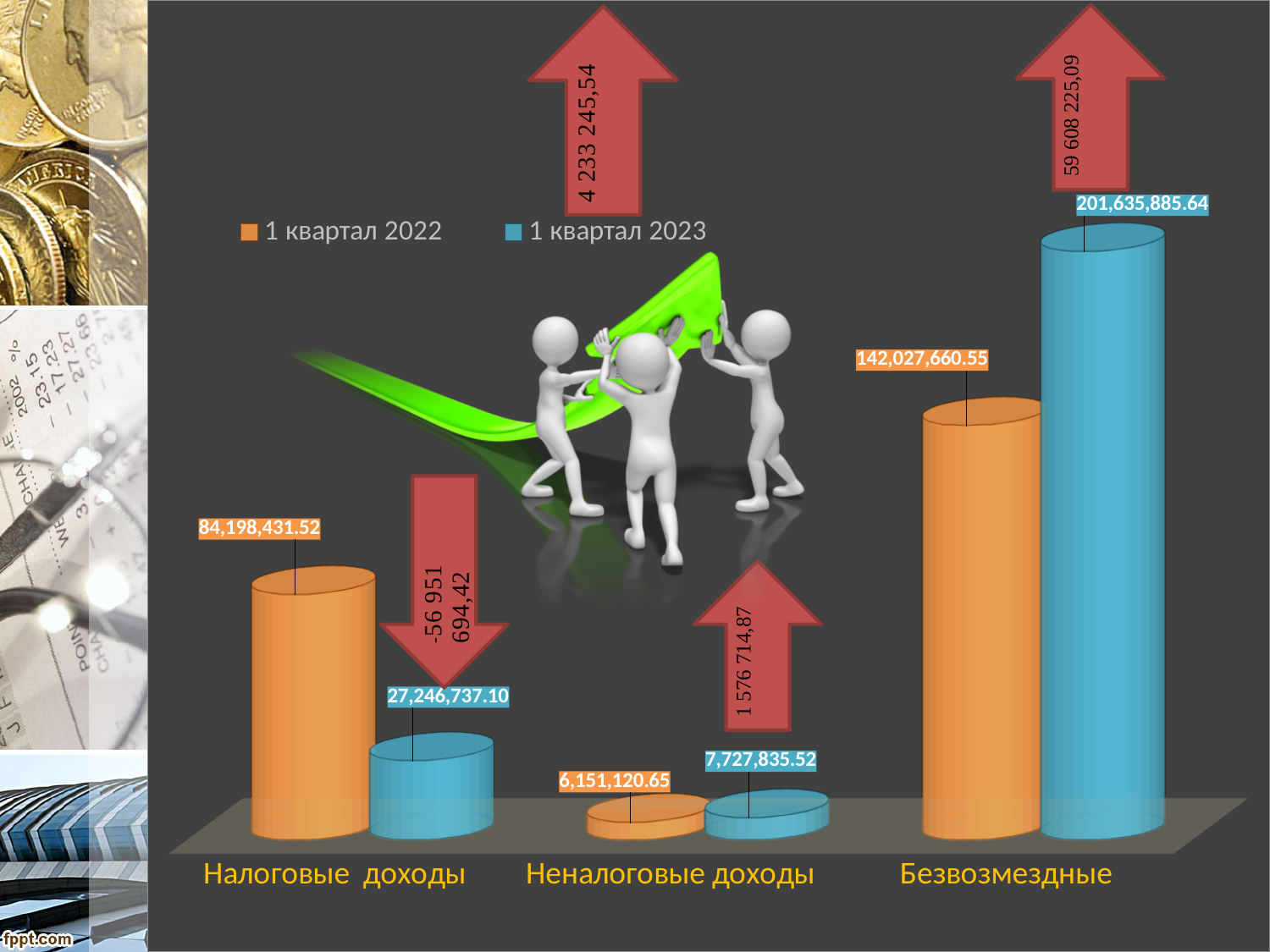
What is the difference between the 1 квартал 2022 and 1 квартал 2023 values for Налоговые доходы? 56,951,694.42 Which category has the highest value in 1 квартал 2023? Безвозмездные What is the difference between the 1 квартал 2023 and 1 квартал 2022 values for Безвозмездные? 59,608,225.09 What kind of chart is shown on the slide? bar chart What is the value for Неналоговые доходы in 1 квартал 2022? 6,151,120.65 What is the value for Налоговые доходы in 1 квартал 2022? 84,198,431.52 How many series does the legend list? 2 Which category has the lowest value in 1 квартал 2022? Неналоговые доходы What is the value for Неналоговые доходы in 1 квартал 2023? 7,727,835.52 Which is larger for Неналоговые доходы: the 1 квартал 2022 value or the 1 квартал 2023 value? 1 квартал 2023 What is the value for Безвозмездные in 1 квартал 2023? 201,635,885.64 How many categories are shown on the x axis? 3